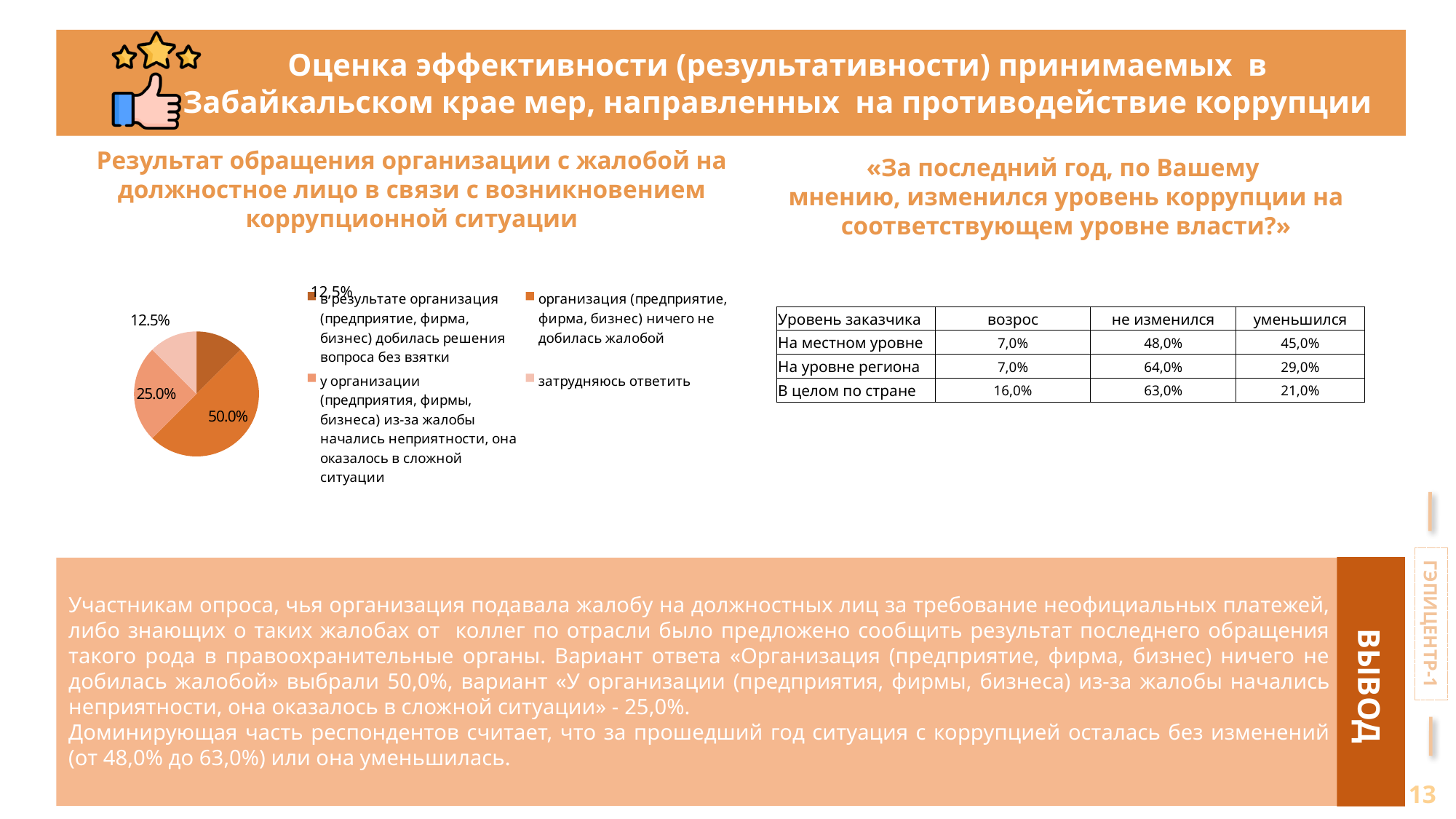
In the pie chart, what is the combined share of the two slices labelled 12.5%? 25.0% In the pie chart, what share is shown for «у организации (предприятия, фирмы, бизнеса) из-за жалобы начались неприятности, она оказалось в сложной ситуации»? 25.0% What kind of chart is shown on the left of the slide under the heading «Результат обращения организации с жалобой на должностное лицо...»? pie chart How many slices does the pie chart on the left have? 4 How many entries does the legend of the pie chart list? 4 Which category has the largest slice in the pie chart? организация (предприятие, фирма, бизнес) ничего не добилась жалобой In the pie chart, what share is shown for «организация (предприятие, фирма, бизнес) ничего не добилась жалобой»? 50.0% In the pie chart, what share is shown for «затрудняюсь ответить»? 12.5% How many slices in the pie chart are labelled 12.5%? 2 What is the title above the pie chart on the left of the slide? Результат обращения организации с жалобой на должностное лицо в связи с возникновением коррупционной ситуации In the pie chart, which slice is larger: «начались неприятности, она оказалось в сложной ситуации» or «затрудняюсь ответить»? начались неприятности, она оказалось в сложной ситуации In the pie chart, by how many percentage points does the «ничего не добилась жалобой» slice exceed the «начались неприятности» slice? 25.0 percentage points